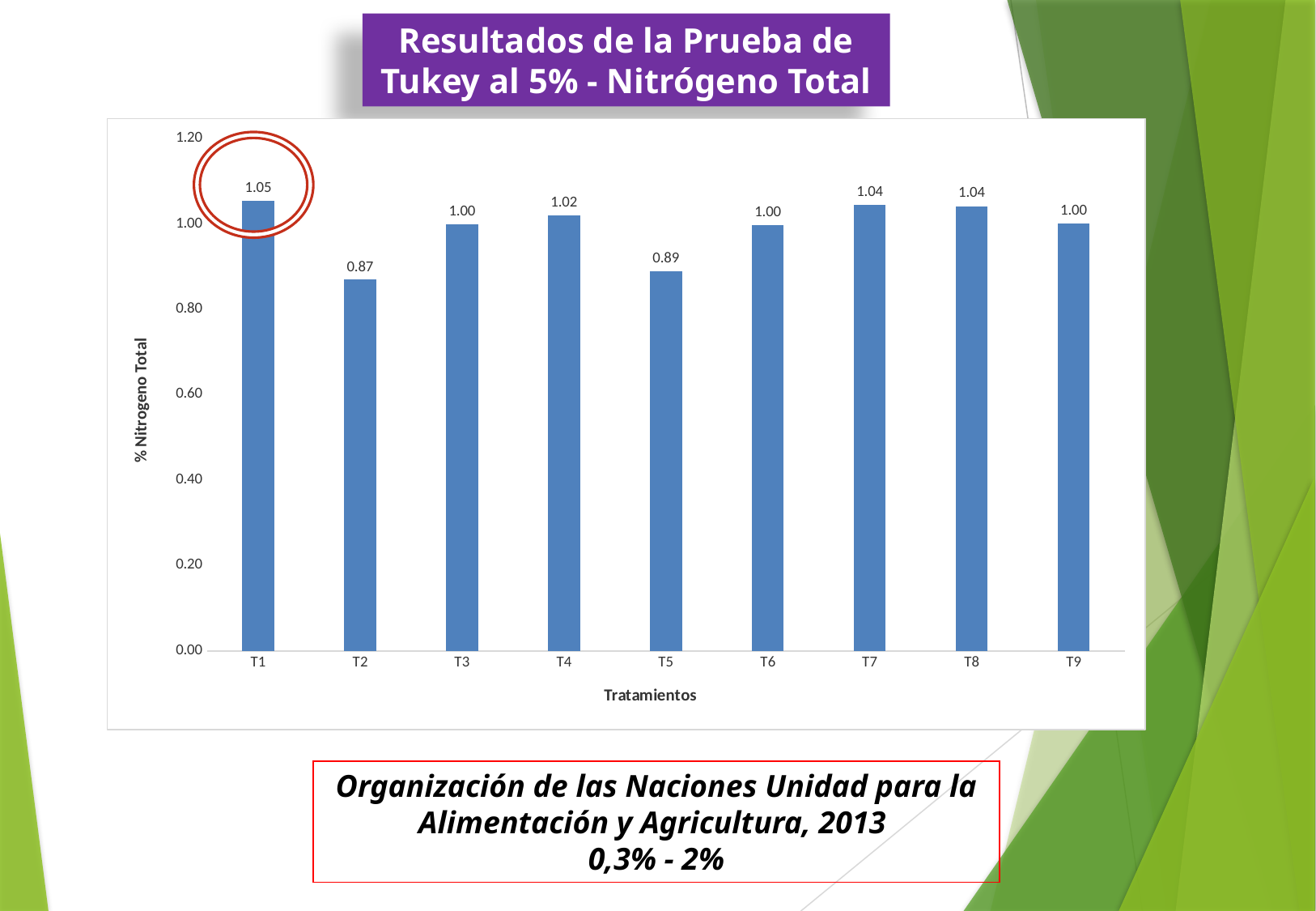
What kind of chart is shown on the slide? bar chart What is the difference between the values for T1 and T2? 0.18 What is the value for T1? 1.05 How many treatments are shown on the x axis? 9 What is the label of the y axis? % Nitrogeno Total What is the value for T4? 1.02 Is the value for T2 greater or less than 1.00? less Which treatment has the lowest % Nitrogeno Total? T2 Which treatment has the highest % Nitrogeno Total? T1 What is the value for T2? 0.87 Which is larger, the value for T4 or the value for T5? T4 What is the value for T5? 0.89